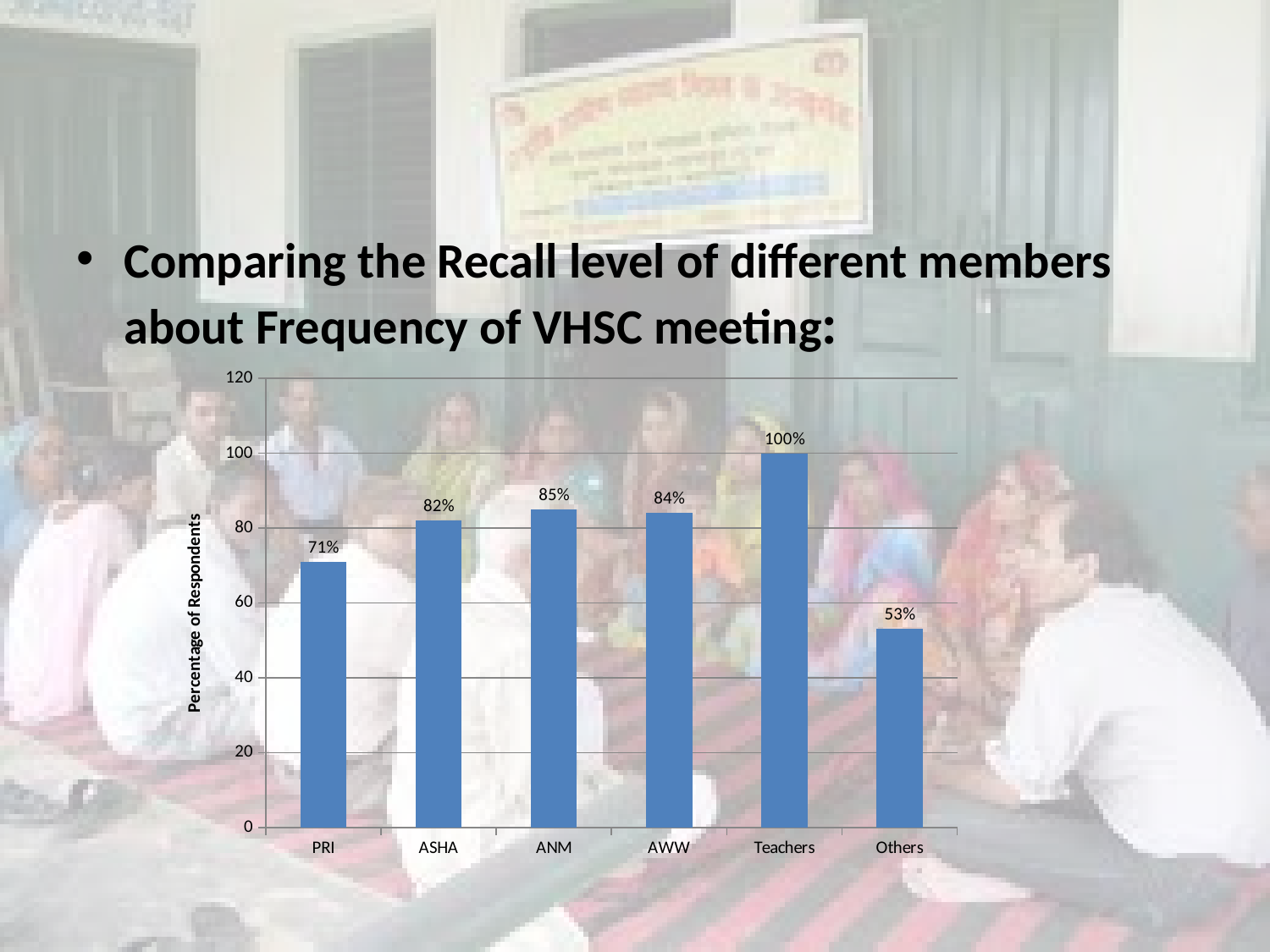
Which has a larger value, ASHA or Others? ASHA Which member category has the highest recall level? Teachers What kind of chart is shown on the slide? Bar chart What is the difference between the values for ANM and PRI? 14% What percentage of PRI respondents recalled the frequency of VHSC meetings? 71% What is the label of the vertical axis? Percentage of Respondents What is the value shown for Teachers? 100% Is the value for AWW greater or less than 80? greater What is the value shown for ASHA? 82% What is the difference between the values for Teachers and Others? 47% How many member categories are shown on the x axis? 6 Which member category has the lowest recall level? Others